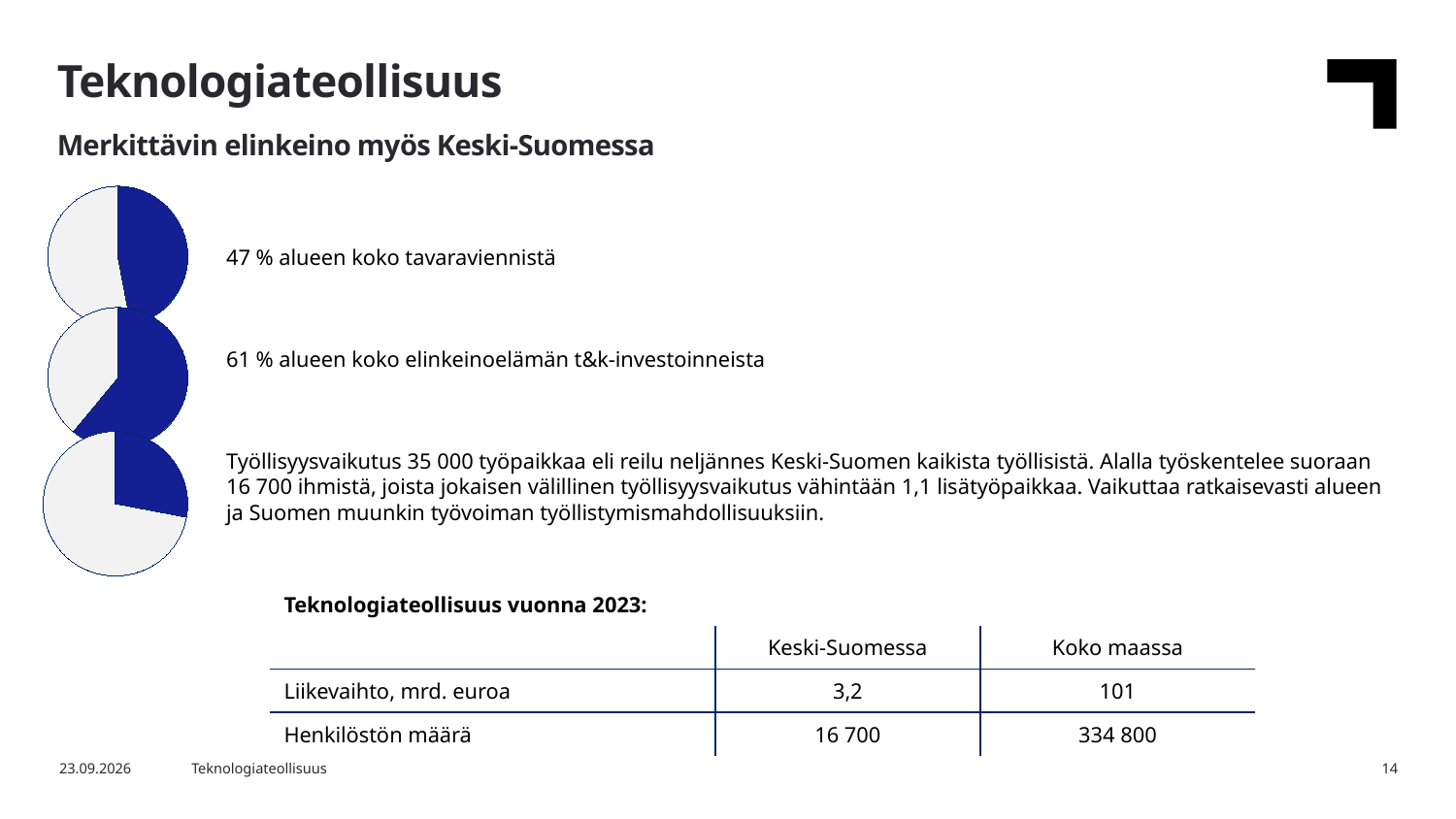
What colour is the highlighted slice in each pie chart? Dark blue How many pie charts are on the slide? 3 Which of the three pie charts has the smallest blue slice? The bottom one (employment share) How many slices does each pie chart have? 2 In the top pie chart, what share of the region's total goods exports (tavaravienti) does the blue slice represent? 47 % What kind of charts are shown on the left side of the slide? Pie charts What is the difference in percentage points between the shares shown for the middle pie chart (61 %) and the top pie chart (47 %)? 14 percentage points In the middle pie chart, what share of the region's business R&D investments (t&k-investoinnit) does the blue slice represent? 61 % In the middle pie chart, is the blue slice greater or less than 50 %? greater Which pie chart has the larger blue slice, the top one (tavaravienti) or the middle one (t&k-investoinnit)? The middle one (t&k-investoinnit) In the bottom pie chart (employment share), is the blue slice greater or less than 50 %? less